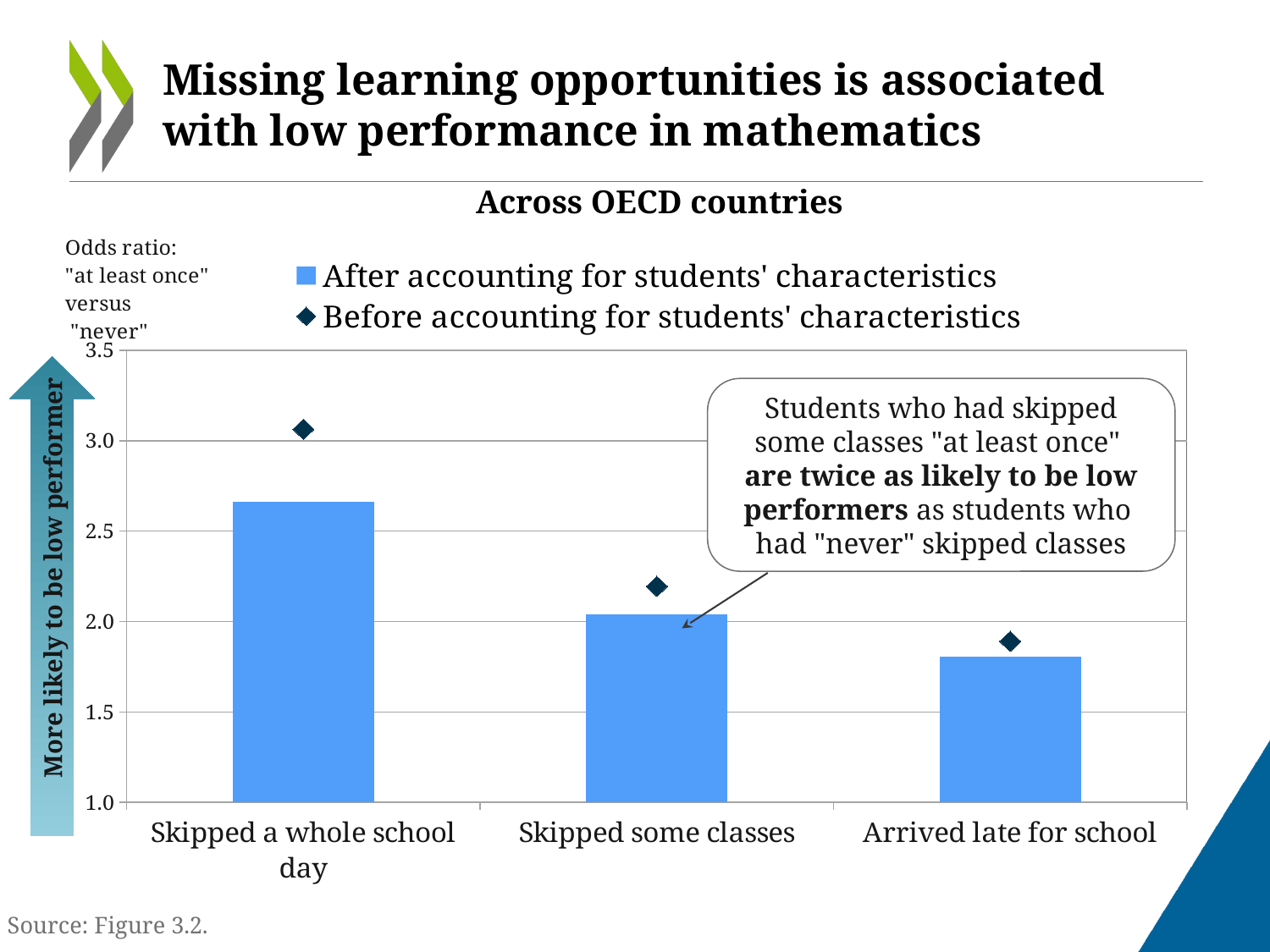
Is the 'After accounting for students' characteristics' value for 'Skipped a whole school day' greater or less than 2.5? greater How many series does the legend list? 2 Do the bar values rise or fall moving from left to right along the x axis? fall Which series is shown with diamond markers? Before accounting for students' characteristics Is the 'Before accounting for students' characteristics' value for 'Skipped some classes' greater or less than 2.0? greater Which category has the lowest value for 'Before accounting for students' characteristics'? Arrived late for school Which is larger for 'After accounting for students' characteristics': 'Skipped a whole school day' or 'Arrived late for school'? Skipped a whole school day How many categories are shown on the x axis? 3 What is the subtitle shown above the chart? Across OECD countries Which category has the highest value for 'After accounting for students' characteristics'? Skipped a whole school day Is the 'After accounting for students' characteristics' value for 'Arrived late for school' greater or less than 2.0? less What kind of chart is shown on the slide? bar chart